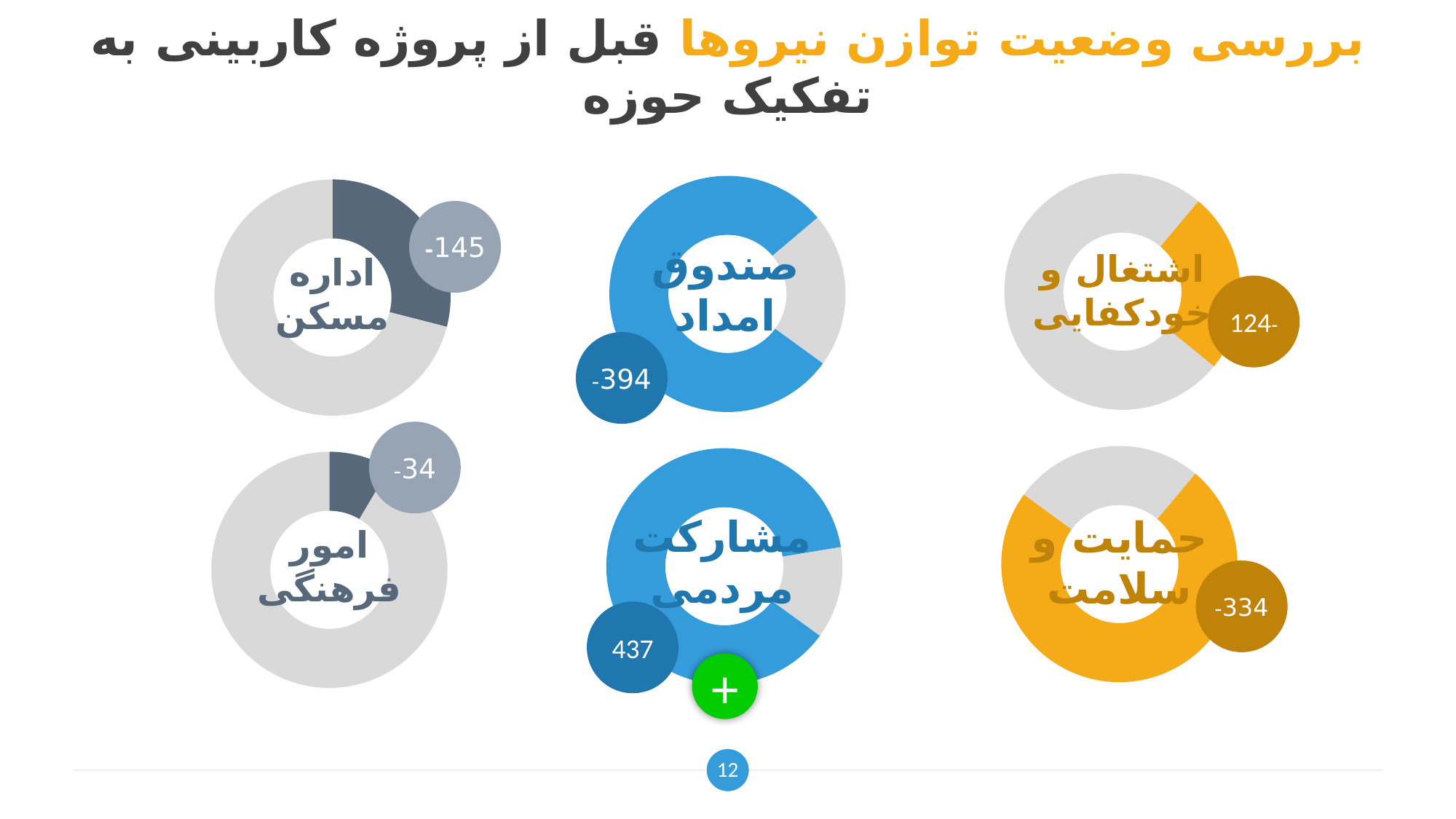
What value is shown for the مشارکت مردمی chart? 437 What value is shown for the اشتغال و خودکفایی chart? -124 What value is shown for the اداره مسکن chart? -145 How many donut charts are on the slide? 6 Which area on the slide has the lowest value? صندوق امداد What kind of chart is used for each area on the slide? Donut chart What value is shown for the حمایت و سلامت chart? -334 Which is larger, the value for اداره مسکن or the value for امور فرهنگی? امور فرهنگی What value is shown for the امور فرهنگی chart? -34 Which area is the only one with a positive value, marked with a green plus sign? مشارکت مردمی What value is shown for the صندوق امداد chart? -394 Which area on the slide has the highest value? مشارکت مردمی